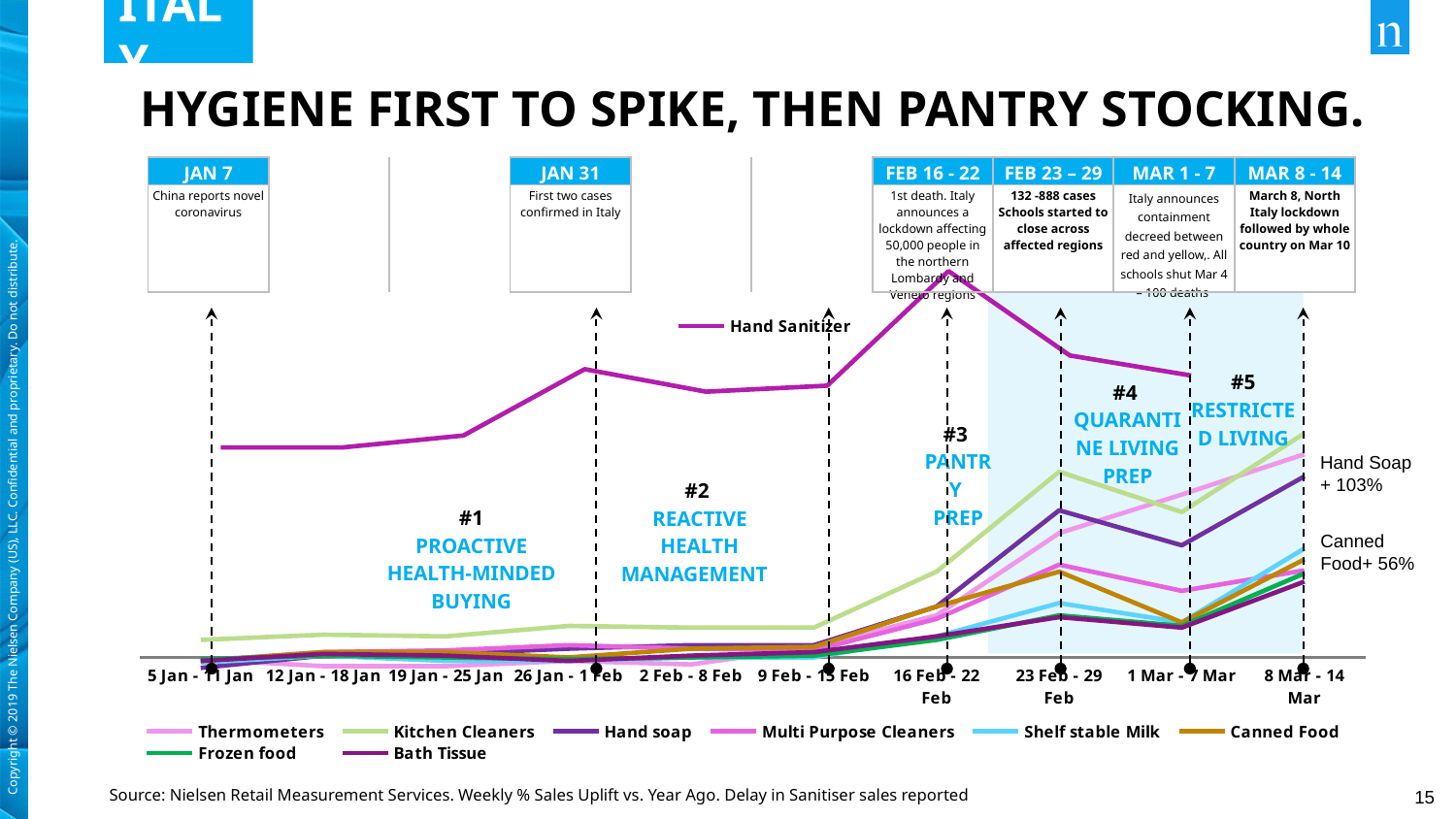
Does the Hand Sanitizer line rise or fall between 16 Feb - 22 Feb and 1 Mar - 7 Mar? Fall How many weekly periods are shown along the x axis? 10 In which week does the Hand Sanitizer line reach its peak? 16 Feb - 22 Feb What sales uplift is annotated for Canned Food at the end of the chart? + 56% Does the Kitchen Cleaners line rise or fall between 1 Mar - 7 Mar and 8 Mar - 14 Mar? Rise What sales uplift is annotated for Hand Soap at the end of the chart? + 103% At the end of the chart, which is larger: the uplift for Hand Soap or for Canned Food? Hand Soap What type of chart is shown on the slide? Line chart Which series reaches the highest point on the chart? Hand Sanitizer Which series is labelled directly on the chart rather than in the bottom legend? Hand Sanitizer What is the title of the slide? HYGIENE FIRST TO SPIKE, THEN PANTRY STOCKING. How many series does the legend at the bottom of the chart list? 8